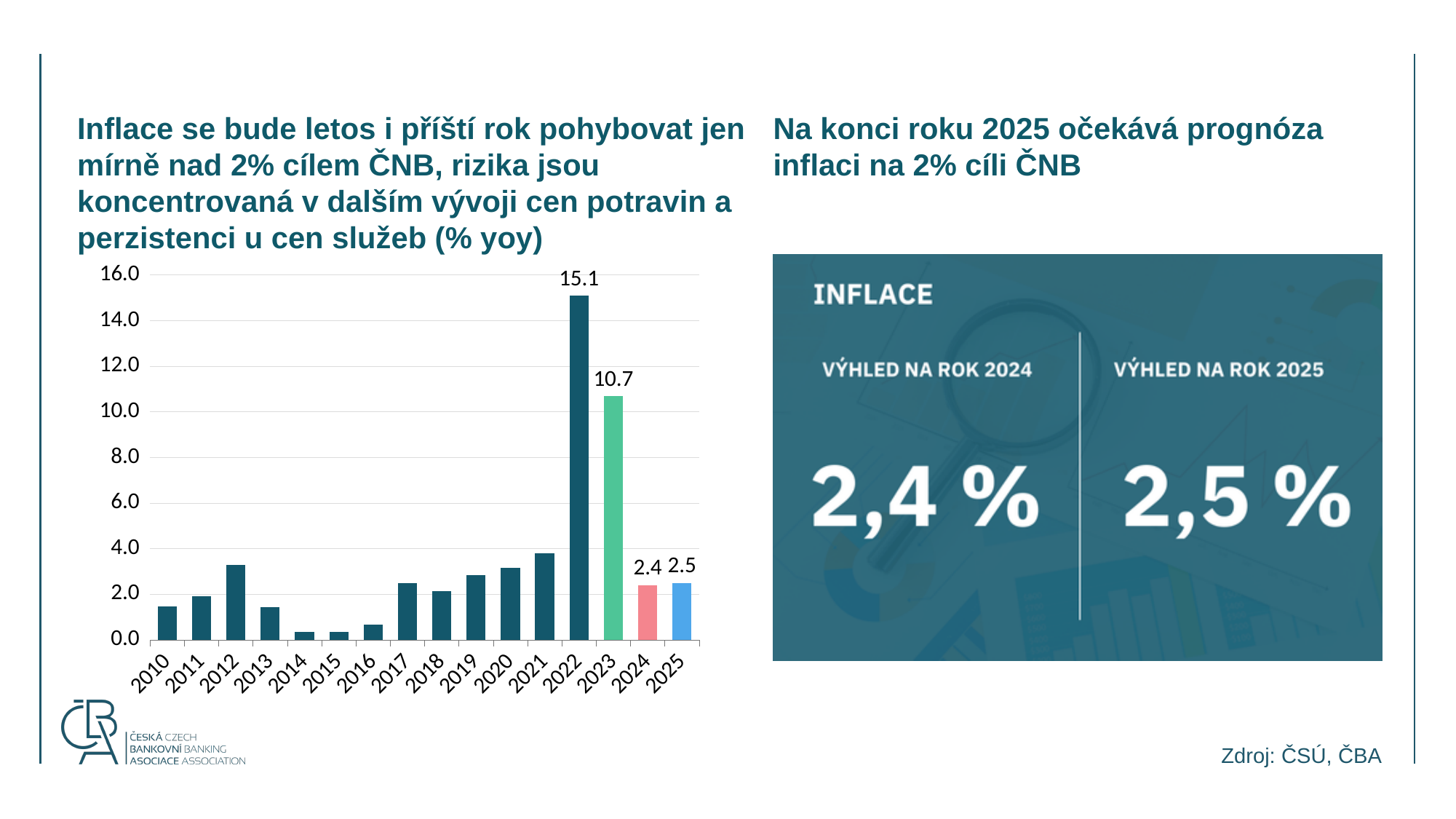
How many years are shown on the x axis of the bar chart? 16 Do the values rise or fall from 2016 to 2022? rise What is the value for 2023 in the bar chart? 10.7 What is the value for 2025 in the bar chart? 2.5 Is the value for 2012 greater or less than 4.0? less Which is larger, the value for 2022 or the value for 2023? 2022 Is the value for 2016 greater or less than 2.0? less What is the value for 2022 in the bar chart? 15.1 What kind of chart is shown on the slide? bar chart What is the difference between the values for 2022 and 2023? 4.4 Which year has the highest value in the bar chart? 2022 What is the value for 2024 in the bar chart? 2.4